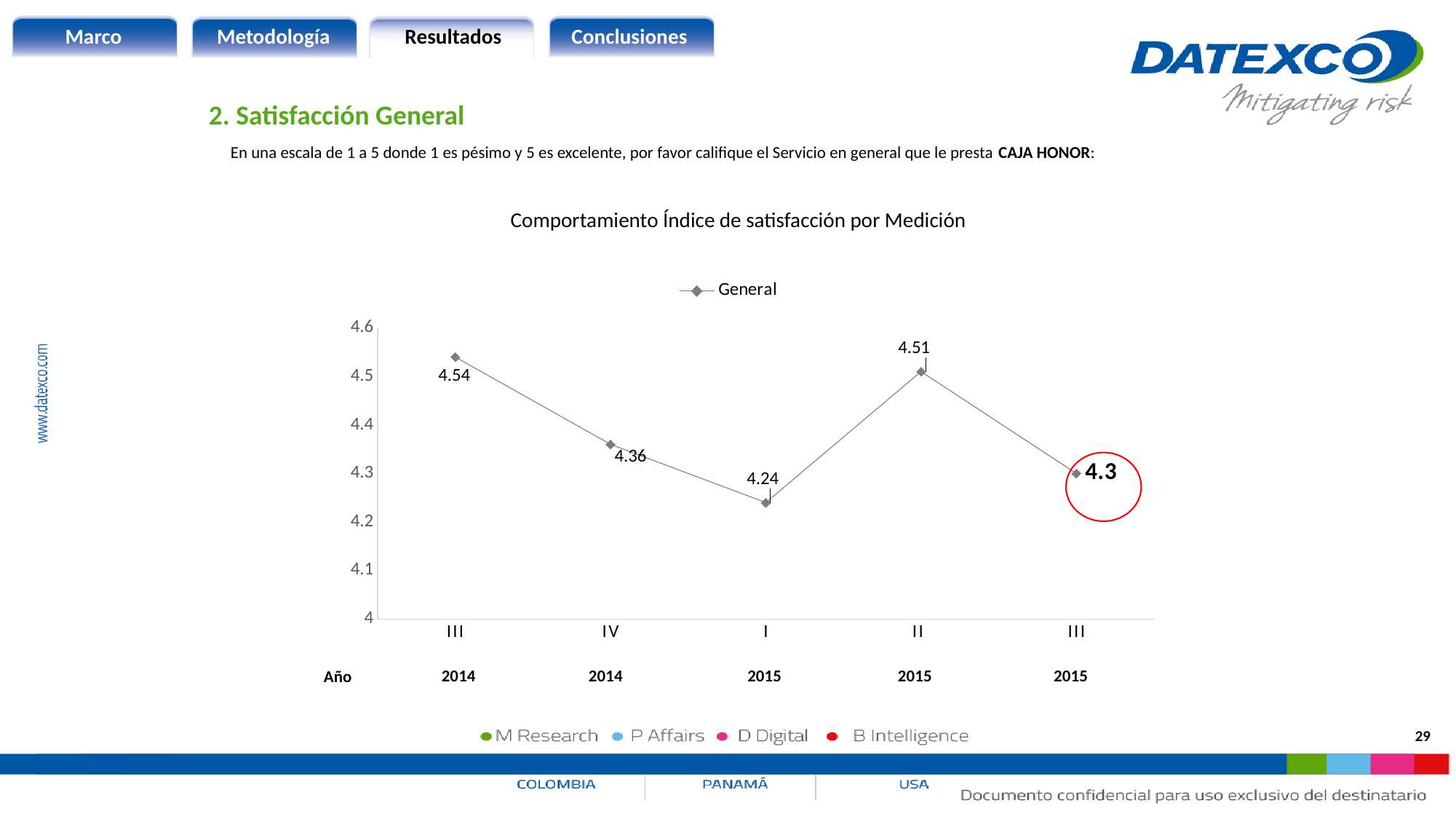
Which is larger, the satisfaction index for IV 2014 or for II 2015? II 2015 What is the title of the chart? Comportamiento Índice de satisfacción por Medición What is the satisfaction index value for measurement III 2014? 4.54 Which measurement has the lowest satisfaction index? I 2015 What kind of chart is shown on the slide? Line chart Does the satisfaction index rise or fall from III 2014 to I 2015? Fall What is the difference between the satisfaction index for II 2015 and III 2015? 0.21 What is the satisfaction index value for measurement I 2015? 4.24 How many series does the chart legend list? 1 What is the satisfaction index value for measurement III 2015? 4.3 How many measurement points are plotted on the chart? 5 Which measurement has the highest satisfaction index? III 2014